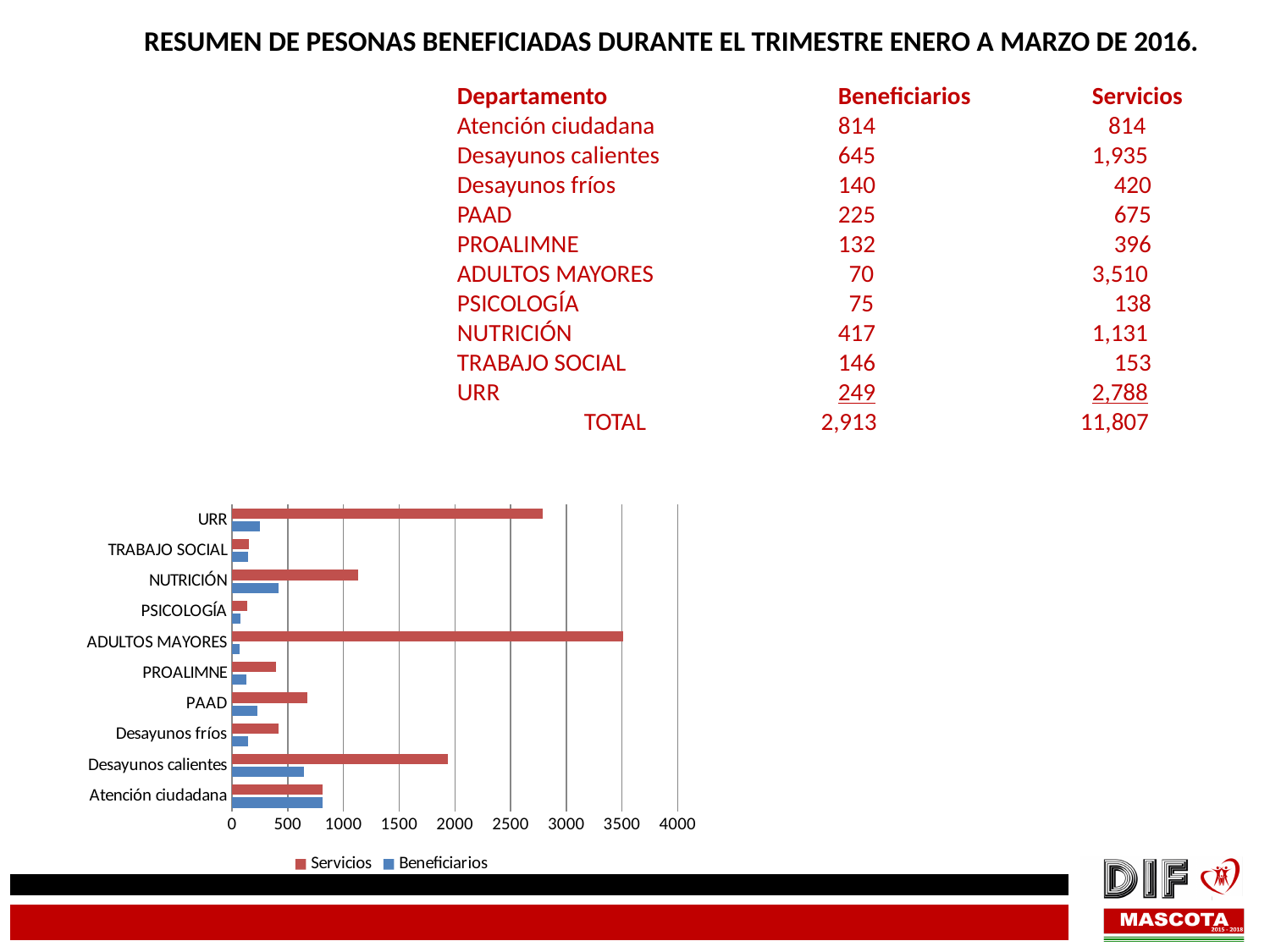
What is the Servicios value for URR? 2,788 Which department has the highest Servicios value in the chart? ADULTOS MAYORES What kind of chart is shown on the slide? bar chart Is the Beneficiarios value for PAAD greater or less than 500? less What is the Beneficiarios value for NUTRICIÓN? 417 Is the Servicios value for ADULTOS MAYORES greater or less than 3000? greater Which has a larger Servicios value, URR or NUTRICIÓN? URR Which department has the highest Beneficiarios value in the chart? Atención ciudadana How many series does the chart legend list? 2 What colour are the Servicios bars in the chart? red How many departments (categories) are plotted in the chart? 10 What is the difference between Servicios and Beneficiarios for Desayunos calientes? 1,290